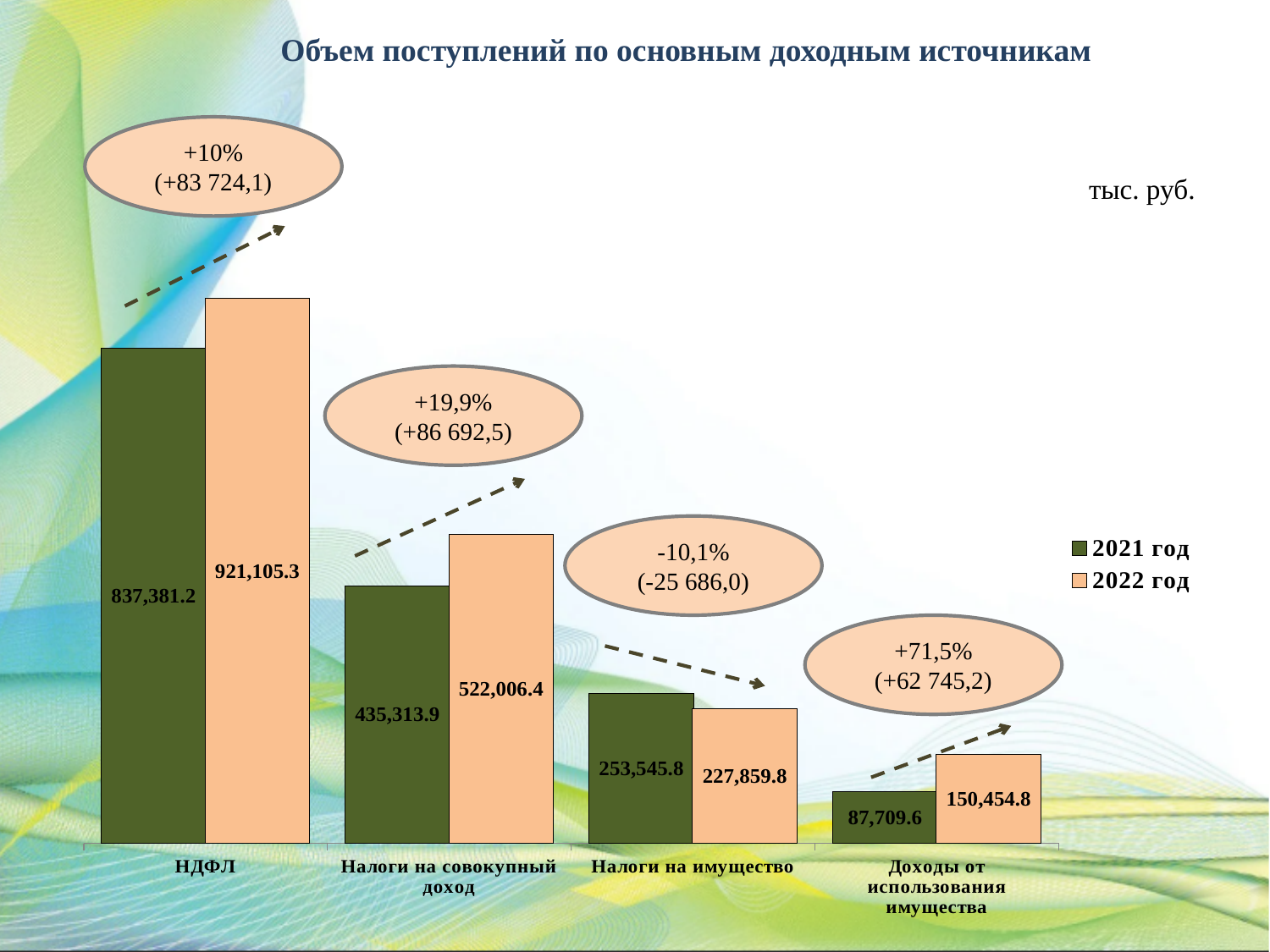
What is the value for НДФЛ in the 2021 год series? 837,381.2 What is the difference between the 2022 год and 2021 год values for НДФЛ? 83,724.1 How many series does the legend list? 2 What is the difference between the 2021 год and 2022 год values for Налоги на имущество? 25,686.0 For Налоги на имущество, which series has the larger value, 2021 год or 2022 год? 2021 год What kind of chart is shown on the slide? Bar chart Which category has the lowest value in the 2021 год series? Доходы от использования имущества What unit of measurement is indicated on the slide for the chart values? тыс. руб. How many categories are shown on the x axis? 4 Which category has the highest value in the 2022 год series? НДФЛ What is the value for Доходы от использования имущества in the 2021 год series? 87,709.6 What is the value for Налоги на совокупный доход in the 2022 год series? 522,006.4